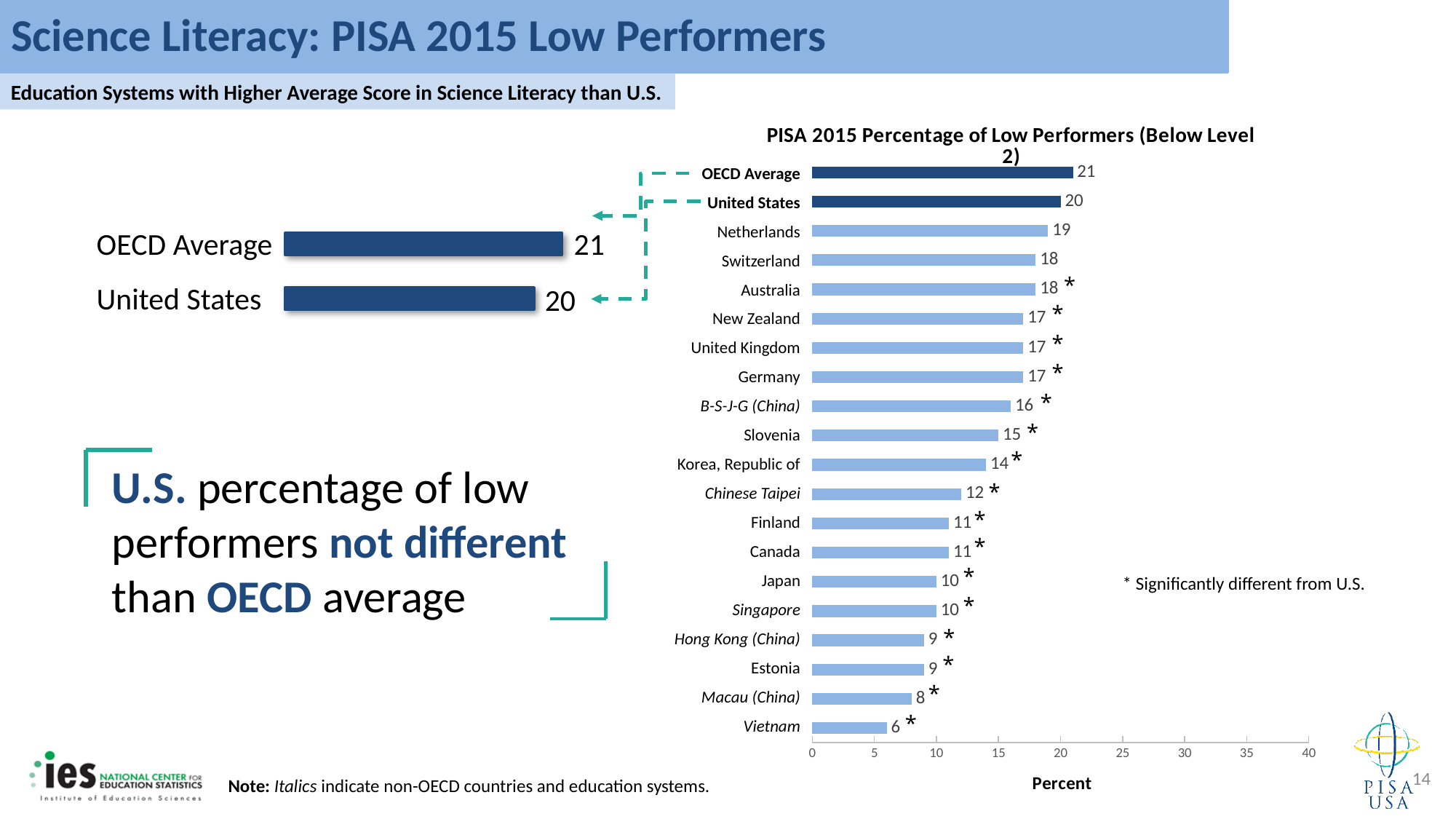
In the chart titled "PISA 2015 Percentage of Low Performers (Below Level 2)", what is the difference between the values for United States and Vietnam? 14 In the chart titled "PISA 2015 Percentage of Low Performers (Below Level 2)", which category has the highest value? OECD Average In the chart titled "PISA 2015 Percentage of Low Performers (Below Level 2)", how many categories are plotted? 20 In the chart titled "PISA 2015 Percentage of Low Performers (Below Level 2)", what is the label of the horizontal axis? Percent In the chart titled "PISA 2015 Percentage of Low Performers (Below Level 2)", which category has the lowest value? Vietnam In the chart titled "PISA 2015 Percentage of Low Performers (Below Level 2)", which is larger, the value for Slovenia or the value for Chinese Taipei? Slovenia In the chart titled "PISA 2015 Percentage of Low Performers (Below Level 2)", what is the value for Netherlands? 19 In the small chart on the left of the slide, what is the difference between the values for OECD Average and United States? 1 In the small chart on the left of the slide, what is the value for OECD Average? 21 In the chart titled "PISA 2015 Percentage of Low Performers (Below Level 2)", what kind of chart is it? Bar chart In the chart titled "PISA 2015 Percentage of Low Performers (Below Level 2)", what is the value for Vietnam? 6 In the chart titled "PISA 2015 Percentage of Low Performers (Below Level 2)", what is the value for Korea, Republic of? 14